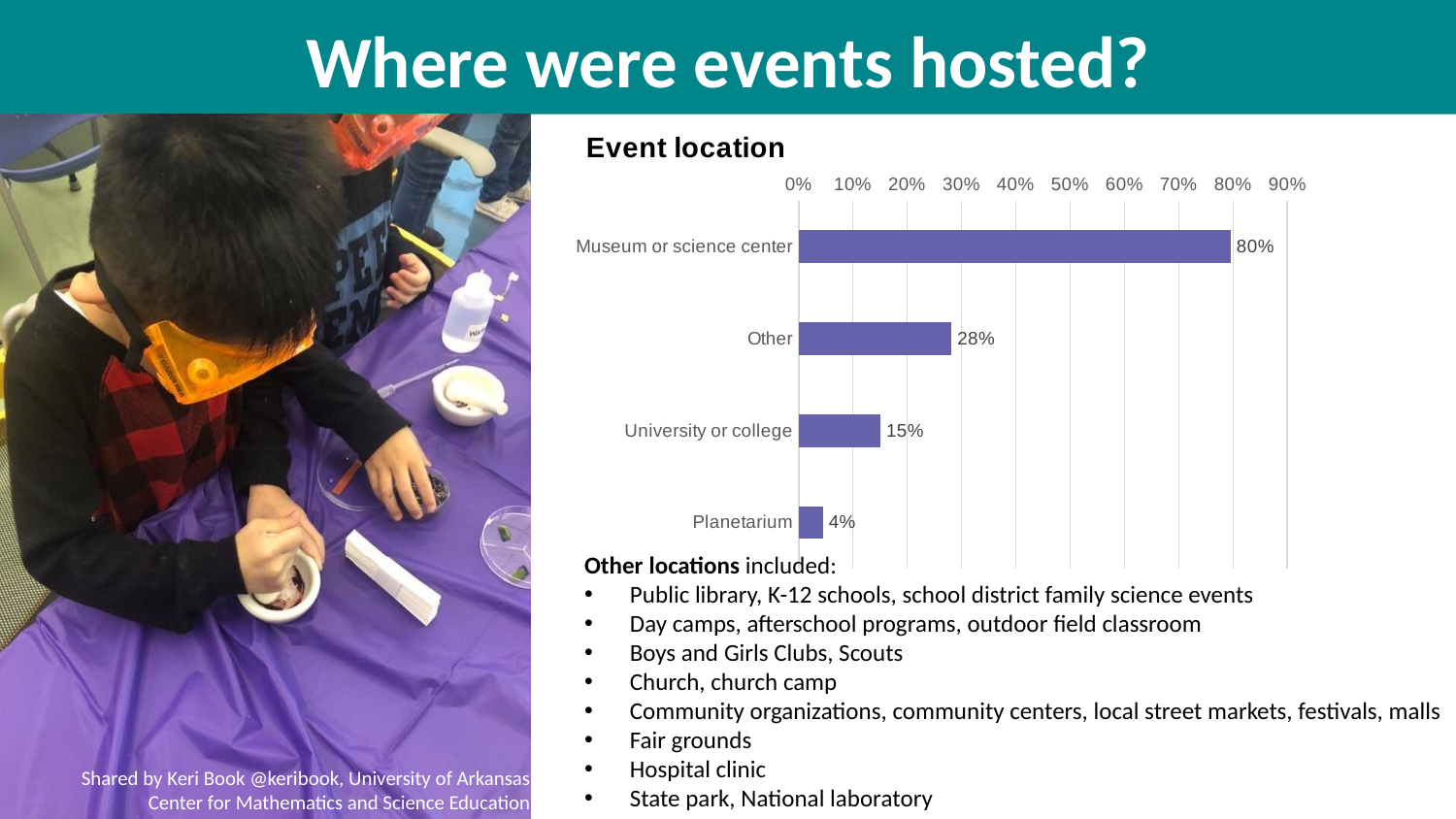
What is the difference between the values for University or college and Planetarium? 11% Which event location has the lowest value? Planetarium What is the difference between the values for Museum or science center and Other? 52% Which event location has the highest value? Museum or science center What is the value for Other? 28% What is the value for University or college? 15% What is the value for Planetarium? 4% Which is larger, the value for Other or the value for University or college? Other What is the title of the chart? Event location What is the value for Museum or science center? 80% How many event location categories are shown in the chart? 4 What kind of chart is shown on the slide? Bar chart